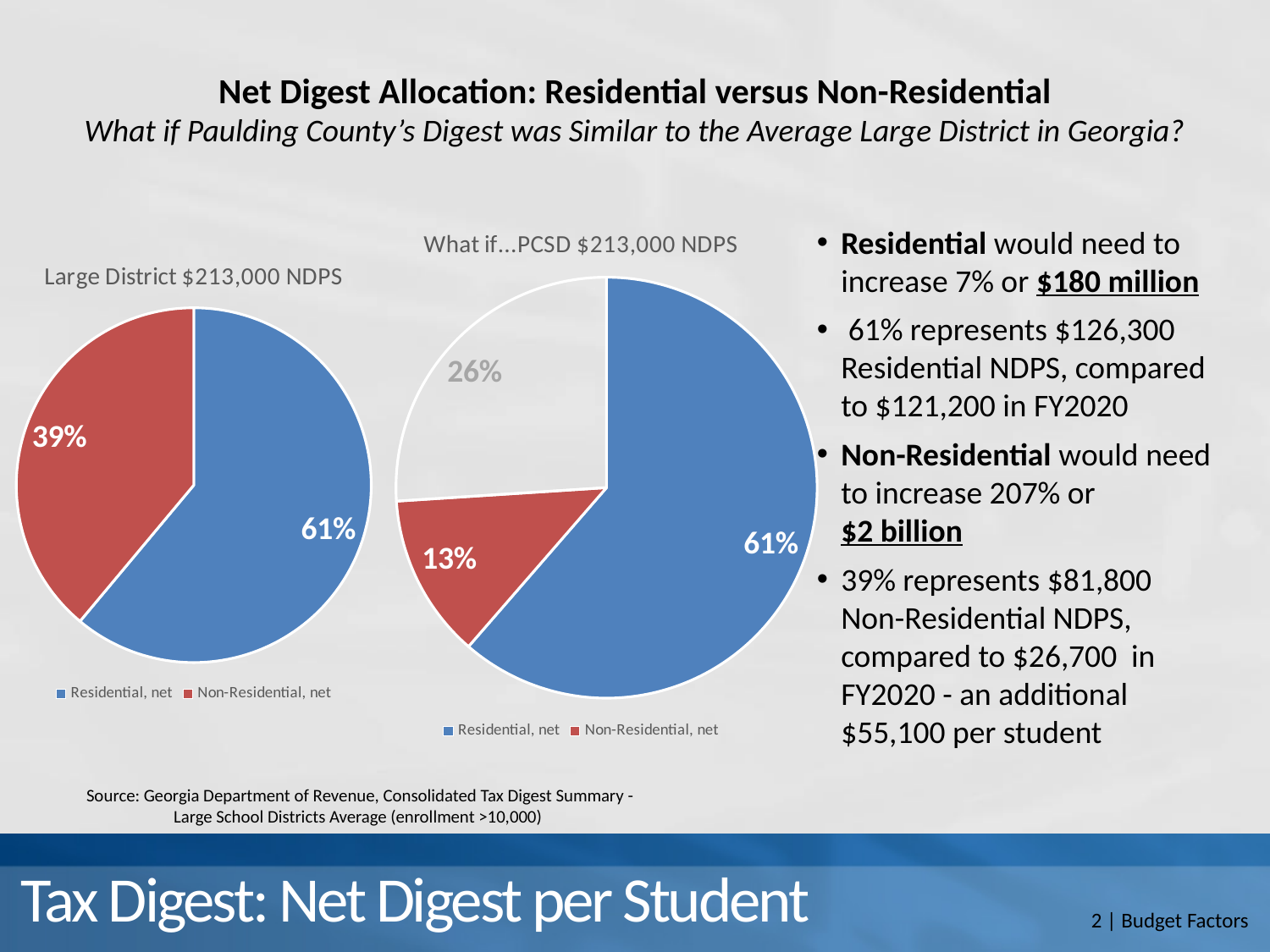
How many entries does the legend of the 'Large District $213,000 NDPS' chart list? 2 In the 'Large District $213,000 NDPS' chart, what share does Non-Residential, net have? 39% In the 'What if...PCSD $213,000 NDPS' chart, which labeled slice is the smallest? Non-Residential, net In the 'What if...PCSD $213,000 NDPS' chart, what share does Non-Residential, net have? 13% What colour is the Non-Residential, net slice in the 'What if...PCSD $213,000 NDPS' chart? red In the 'What if...PCSD $213,000 NDPS' chart, what percentage is shown on the grey slice? 26% In the 'Large District $213,000 NDPS' chart, which slice is the largest? Residential, net Which chart has the larger Non-Residential, net share: 'Large District $213,000 NDPS' or 'What if...PCSD $213,000 NDPS'? Large District $213,000 NDPS What kind of chart is the 'Large District $213,000 NDPS' chart? pie chart In the 'Large District $213,000 NDPS' chart, what share does Residential, net have? 61% In the 'Large District $213,000 NDPS' chart, what is the difference between the Residential, net share and the Non-Residential, net share? 22%